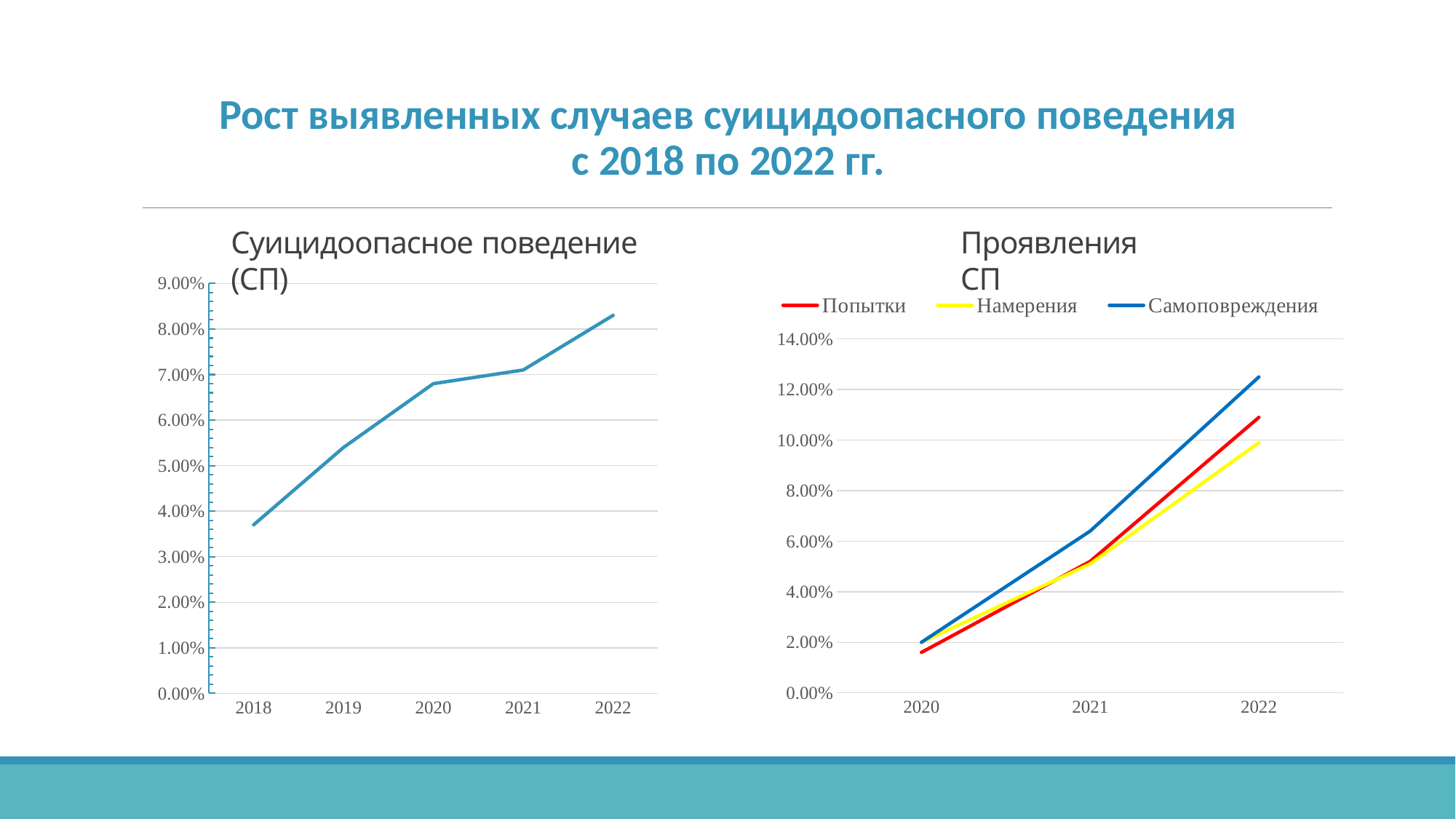
What kind of chart is the left chart titled "Суицидоопасное поведение (СП)"? line chart In the left chart "Суицидоопасное поведение (СП)", which year has the highest value? 2022 In the left chart "Суицидоопасное поведение (СП)", is the value for 2018 greater or less than 4.00%? less How many series does the legend of the right chart "Проявления СП" list? 3 How many years are plotted on the x axis of the left chart "Суицидоопасное поведение (СП)"? 5 In the right chart "Проявления СП", which series has the highest value in 2022? Самоповреждения In the right chart "Проявления СП", which is larger in 2022: Попытки or Намерения? Попытки In the left chart "Суицидоопасное поведение (СП)", do the values rise or fall from 2018 to 2022? rise In the left chart "Суицидоопасное поведение (СП)", is the value for 2022 greater or less than 8.00%? greater In the right chart "Проявления СП", is the value for Самоповреждения in 2022 greater or less than 12.00%? greater In the left chart "Суицидоопасное поведение (СП)", which year has the lowest value? 2018 In the right chart "Проявления СП", what colour is the line for Намерения? yellow